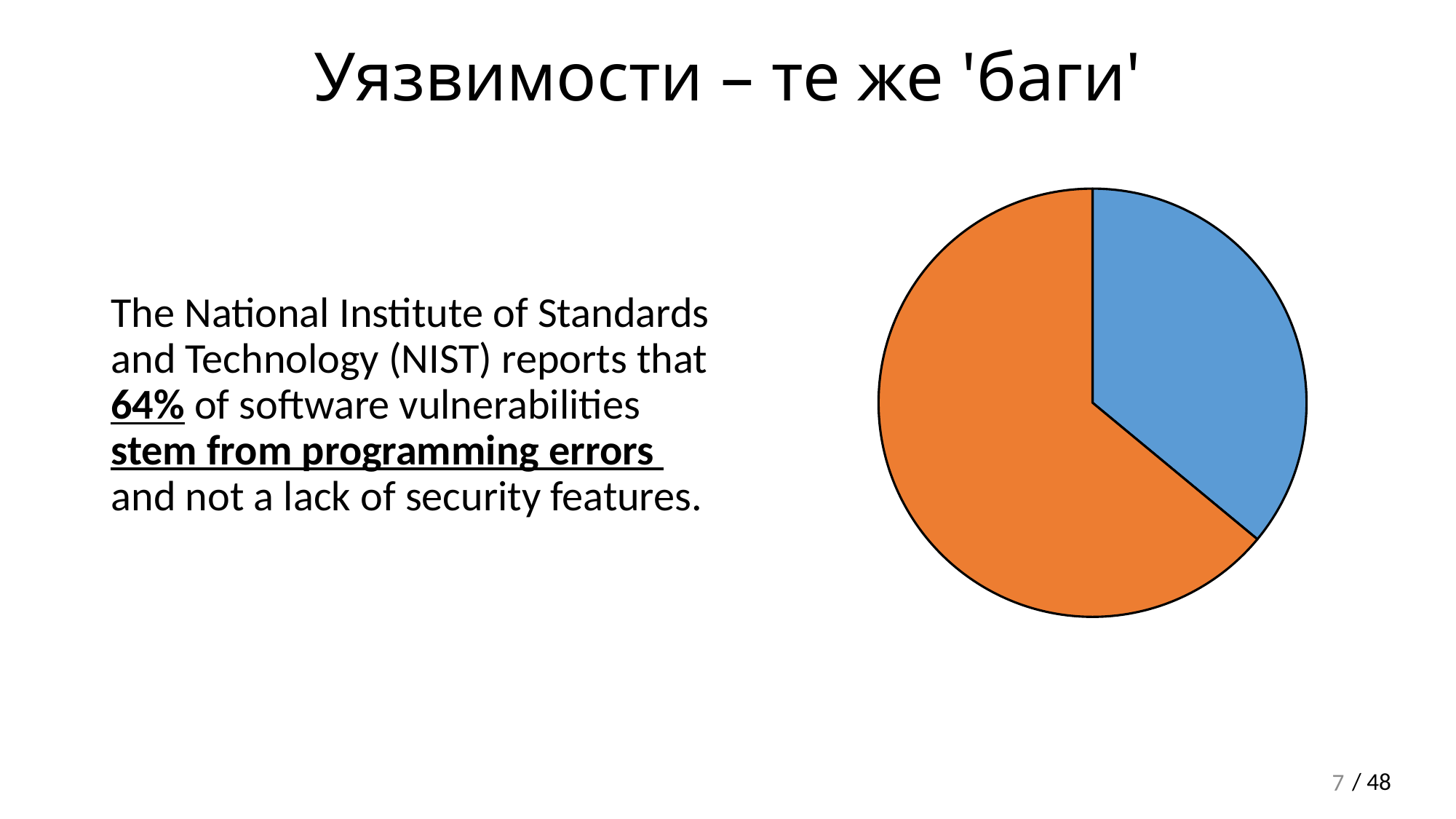
What two colours are used for the slices of the pie chart? orange and blue Which slice of the pie chart is the smallest? the blue slice Which slice of the pie chart is the largest? the orange slice Does the orange slice take up more or less than half of the pie chart? more Does the pie chart have a legend? no Which slice of the pie chart is larger, the orange one or the blue one? orange Does the blue slice take up more or less than half of the pie chart? less What kind of chart is shown on the slide? pie chart How many slices does the pie chart have? 2